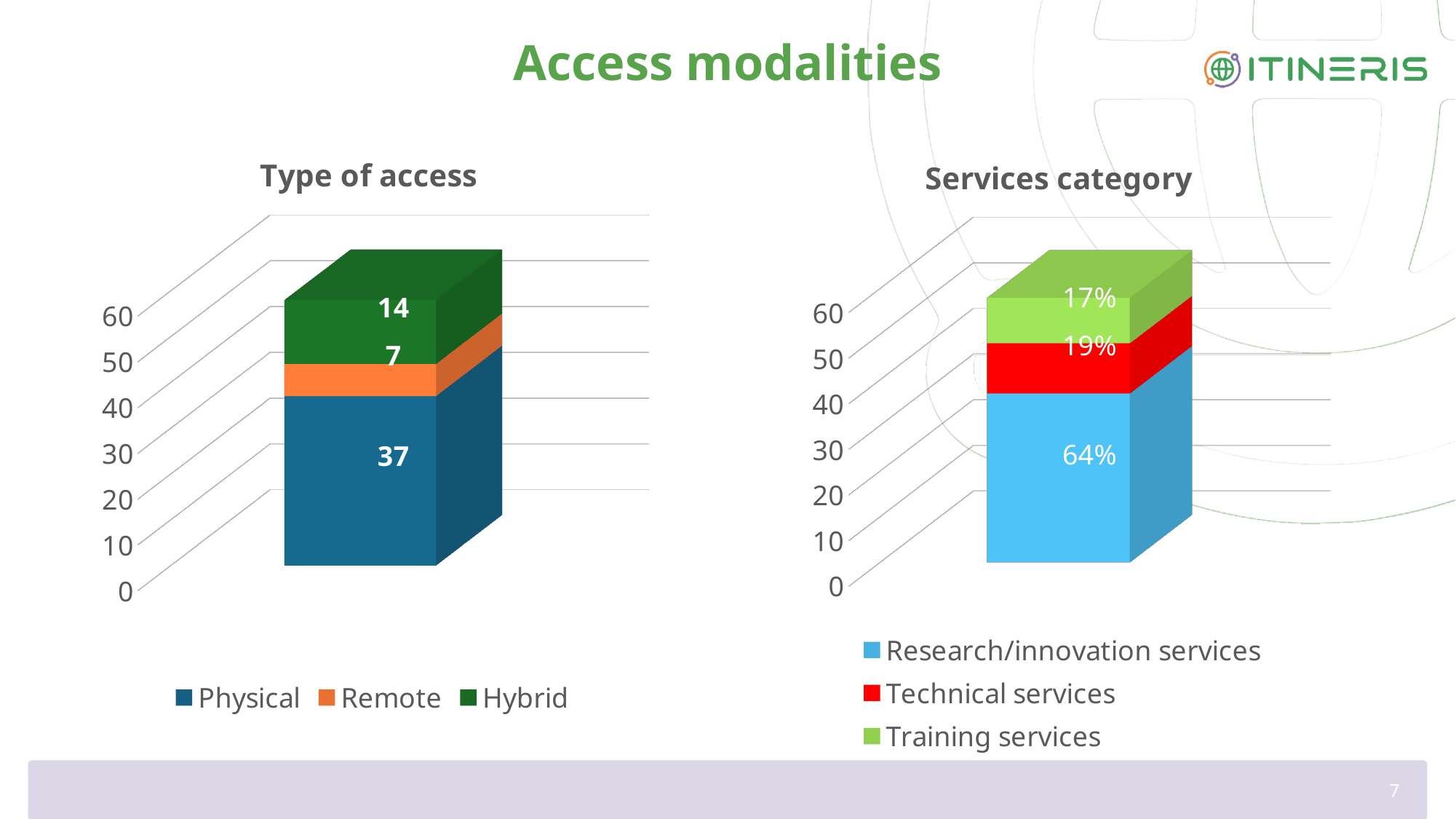
In the 'Services category' chart, what is the value for Research/innovation services? 64% In the 'Services category' chart, which is larger: Technical services or Training services? Technical services In the 'Type of access' chart, what is the difference between the Physical and Hybrid values? 23 How many series does the legend of the 'Services category' chart list? 3 In the 'Type of access' chart, what is the value for Physical? 37 What kind of chart is the 'Type of access' chart? Stacked bar chart In the 'Type of access' chart, what is the total of the stacked bar? 58 In the 'Type of access' chart, what is the value for Remote? 7 In the 'Type of access' chart, which series has the lowest value? Remote In the 'Services category' chart, what is the value for Technical services? 19% In the 'Type of access' chart, what is the value for Hybrid? 14 In the 'Type of access' chart, which series has the highest value? Physical